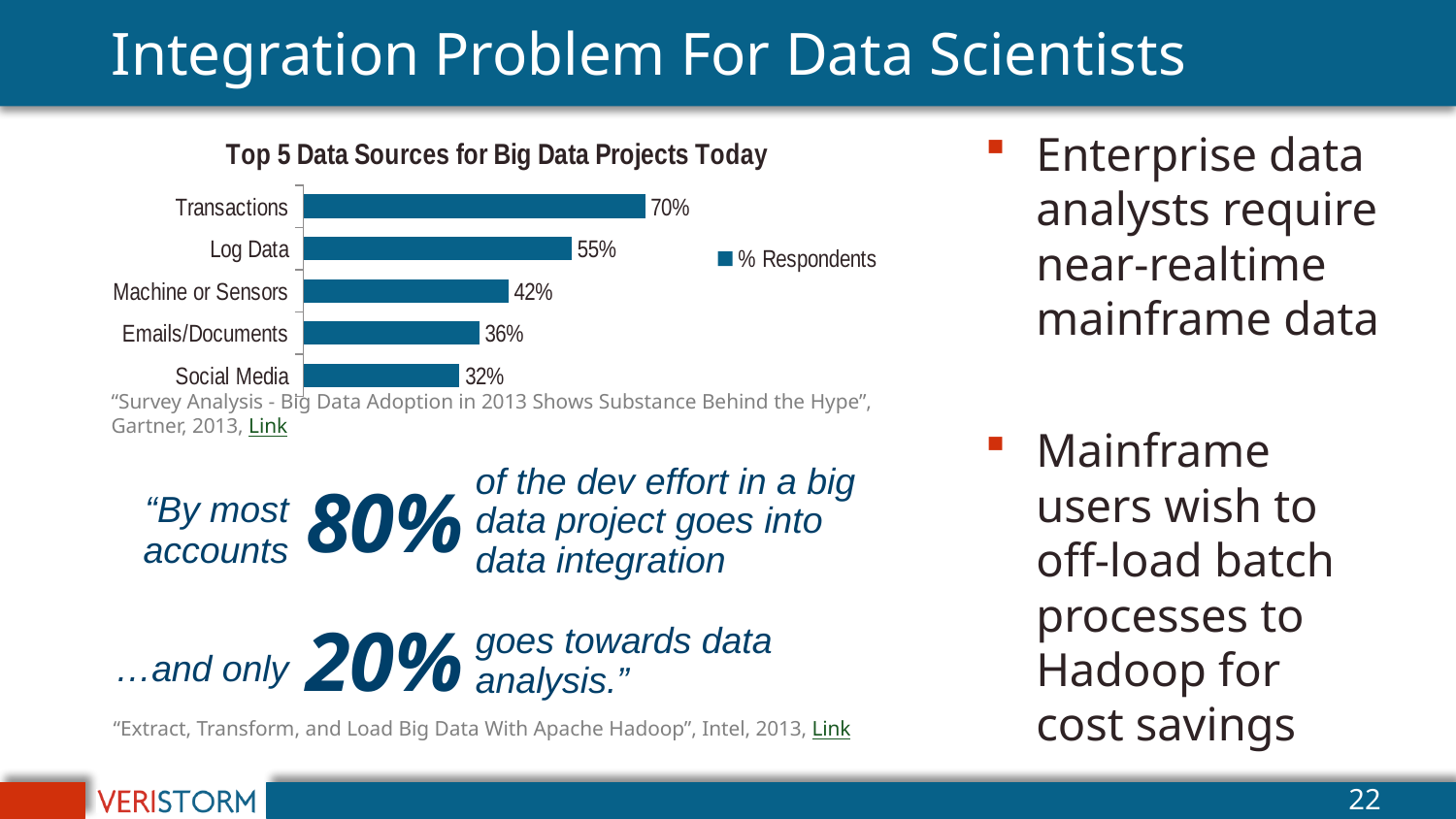
Which data source has the highest percentage of respondents? Transactions What is the difference between the values for Emails/Documents and Social Media? 4% What type of chart is shown on the slide? Bar chart What percentage of respondents cited Transactions as a data source? 70% How many data sources are shown in the chart? 5 What is the value for Emails/Documents? 36% Which has a higher value, Machine or Sensors or Emails/Documents? Machine or Sensors What is the title of the chart? Top 5 Data Sources for Big Data Projects Today What is the difference between the values for Transactions and Log Data? 15% What is the value for Machine or Sensors? 42% Which data source has the lowest percentage of respondents? Social Media What is the value for Log Data? 55%